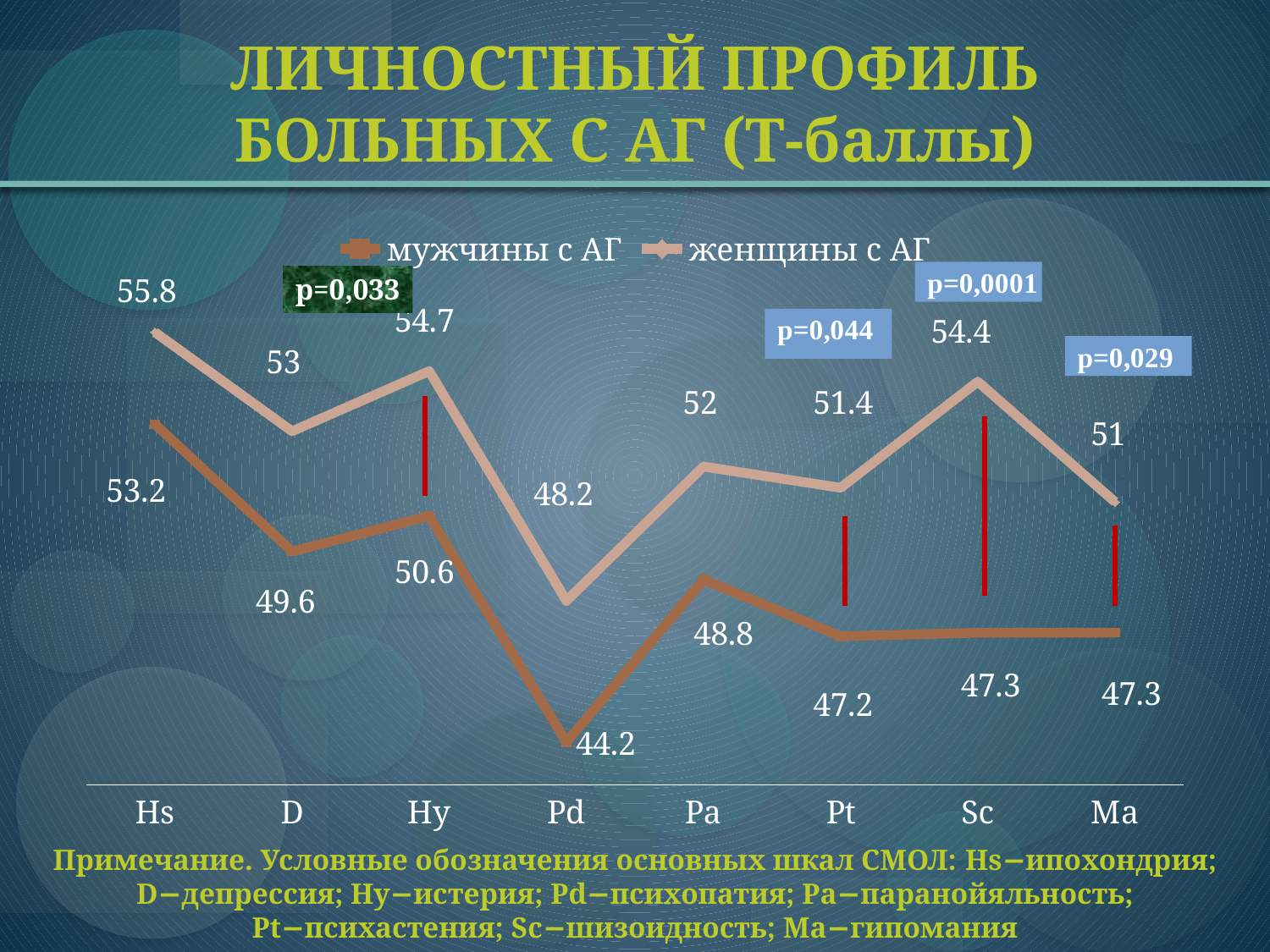
Which category has the lowest value for мужчины с АГ? Pd What kind of chart is shown on the slide? line chart What is the value for мужчины с АГ at Sc? 47.3 What p-value is shown above the Sc category? p=0,0001 What is the value for женщины с АГ at Hs? 55.8 How many series does the legend list? 2 What is the difference between женщины с АГ and мужчины с АГ at Sc? 7.1 Which series has the larger value at Pt, мужчины с АГ or женщины с АГ? женщины с АГ What is the value for мужчины с АГ at Pd? 44.2 Do the values for мужчины с АГ rise or fall from Hs to D? fall How many categories are shown on the x axis? 8 Which category has the highest value for женщины с АГ? Hs